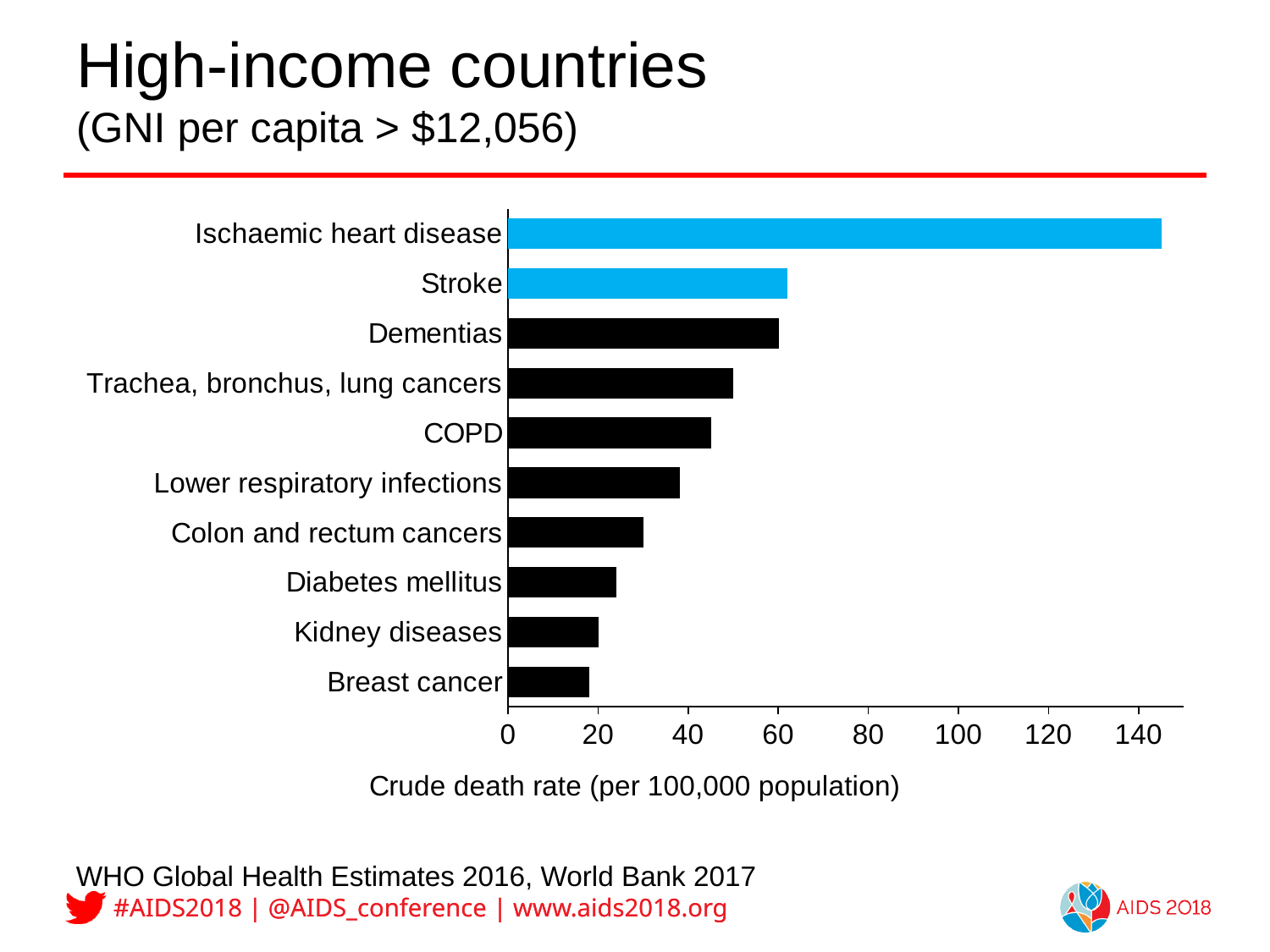
Is the value for Stroke greater or less than 80? less How many causes of death are plotted in the chart? 10 Is the value for Ischaemic heart disease greater or less than 120? greater What kind of chart is shown on the slide? bar chart What is the label of the horizontal axis of the chart? Crude death rate (per 100,000 population) Which has a higher crude death rate, Lower respiratory infections or Colon and rectum cancers? Lower respiratory infections Which has a higher crude death rate, Ischaemic heart disease or Stroke? Ischaemic heart disease Is the value for Dementias greater or less than 40? greater Which cause of death has the lowest crude death rate in the chart? Breast cancer Which cause of death has the highest crude death rate in the chart? Ischaemic heart disease